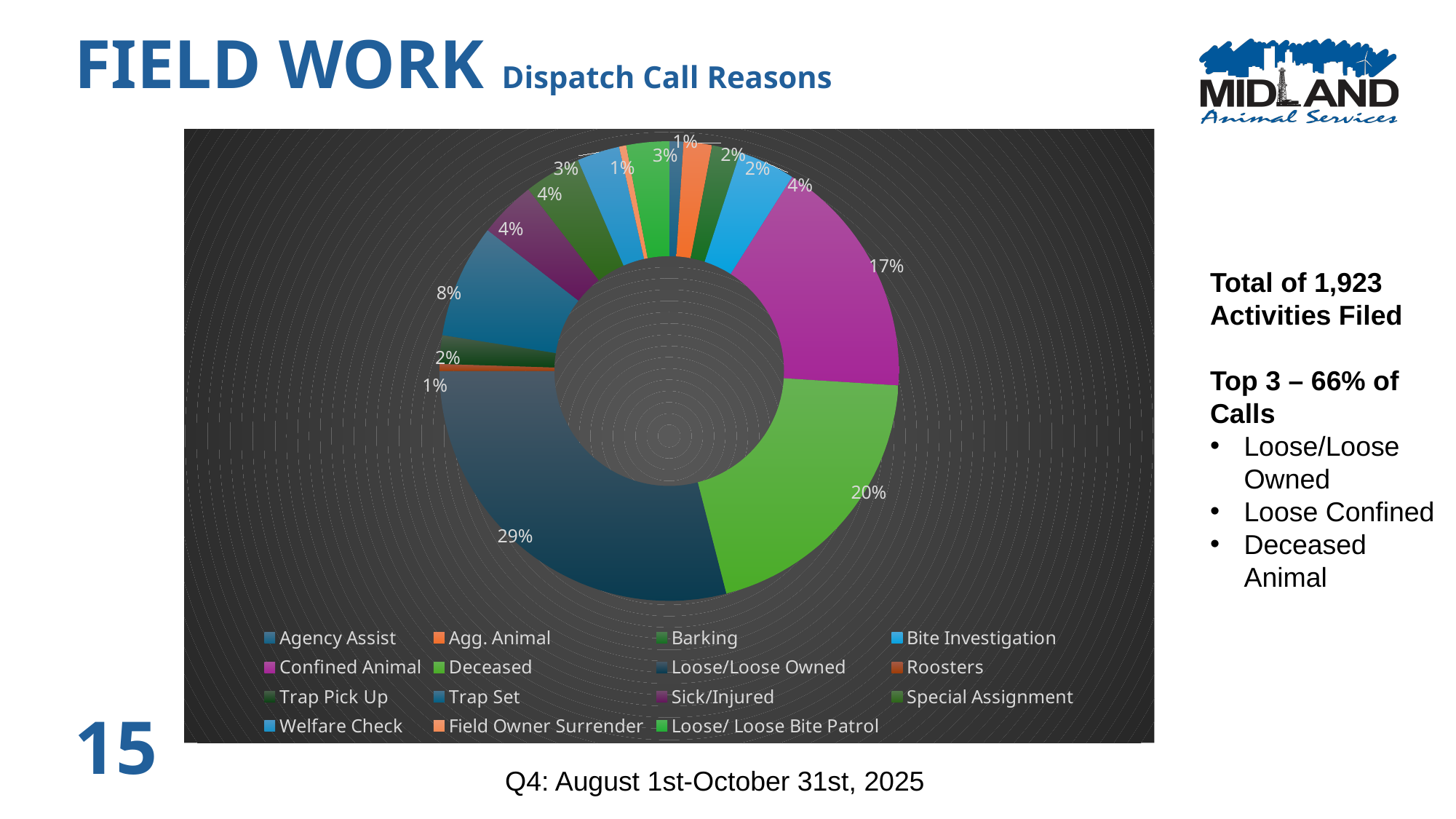
What is the difference in percentage points between the Loose/Loose Owned share and the Deceased share? 9 percentage points Which has a larger share of calls, Trap Set or Confined Animal? Confined Animal What type of chart is shown on the slide? Doughnut (pie) chart How many dispatch call reason categories are listed in the legend? 15 Which dispatch call reason has the largest share of calls? Loose/Loose Owned Which has a larger share of calls, Confined Animal or Deceased? Deceased What is the subtitle of the chart on the slide? Dispatch Call Reasons What is the combined share of the top 3 call reasons according to the slide? 66% What percentage of dispatch calls were for Deceased? 20% What percentage of dispatch calls were for Trap Set? 8% What percentage of dispatch calls were for Confined Animal? 17% What percentage of dispatch calls were for Loose/Loose Owned? 29%